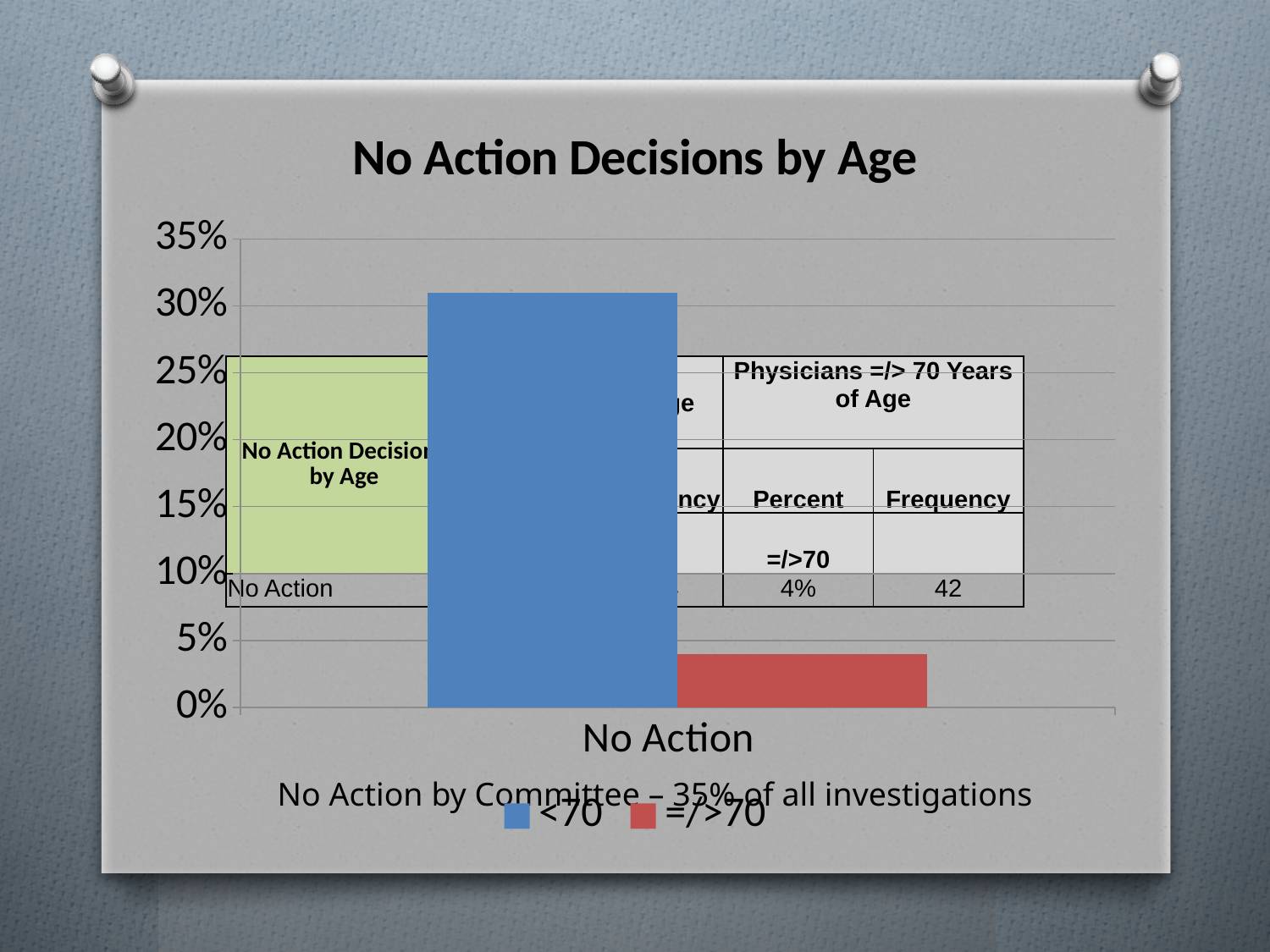
How many series does the legend list? 2 Which series has the shorter bar for No Action? =/>70 Is the bar for <70 larger or smaller than the bar for =/>70? larger What kind of chart is shown on the slide? bar chart Is the value for <70 greater or less than 20%? greater What colour is the bar for the <70 series? blue Which series has the taller bar for No Action? <70 What is the title of the chart? No Action Decisions by Age Is the value for <70 greater or less than 25%? greater How many categories are shown on the x axis? 1 What is the category label on the x axis? No Action Is the value for =/>70 greater or less than 5%? less